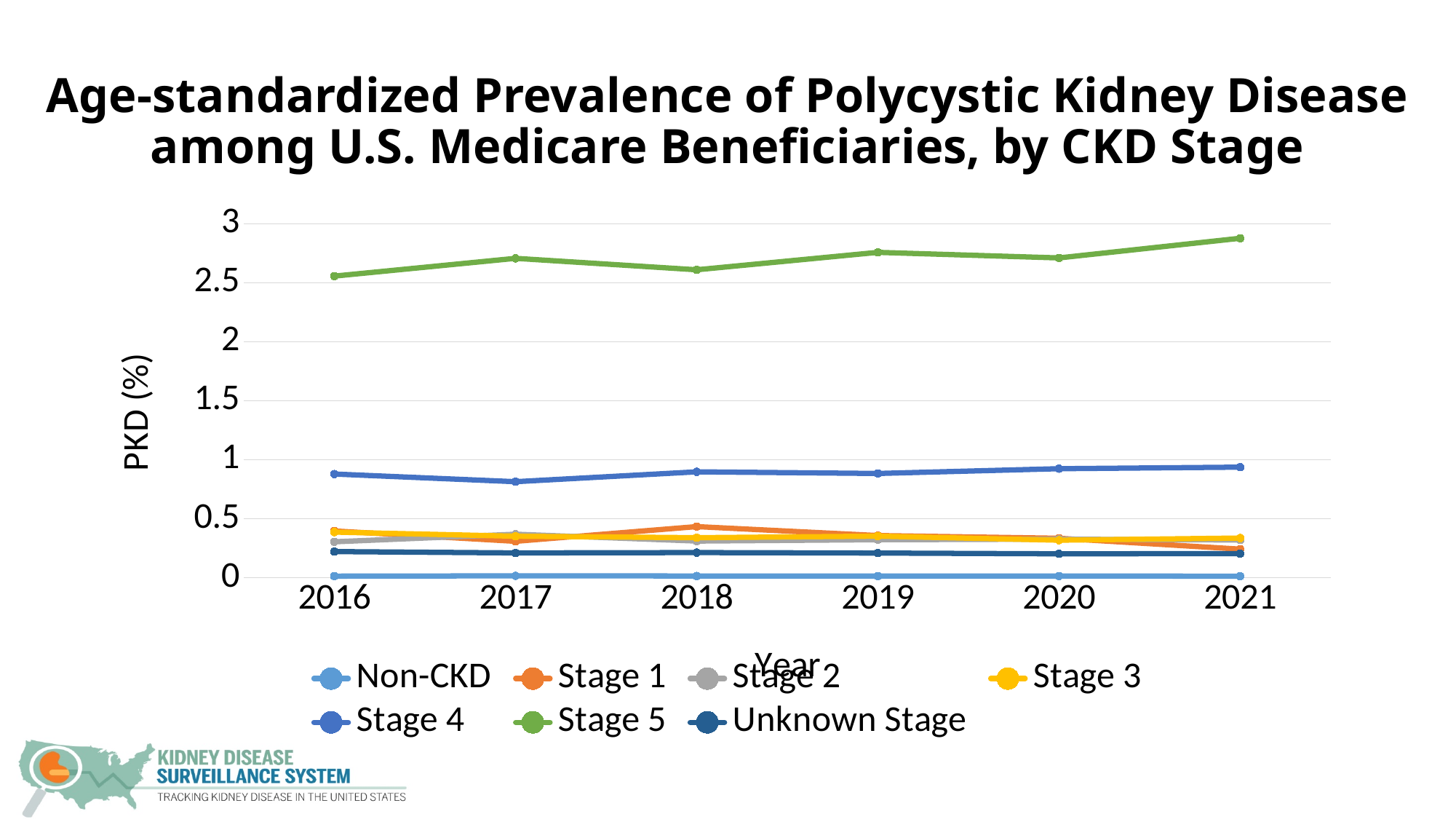
Which series has the lowest PKD prevalence across all years? Non-CKD What is the label on the y axis? PKD (%) How many years are plotted along the x axis? 6 In which year does the Stage 5 line reach its highest value? 2021 What kind of chart is shown on the slide? line chart In which year does the Stage 4 line reach its lowest value? 2017 Is the value for Stage 5 in 2019 greater or less than 2.5? greater In 2020, which is larger: the value for Stage 4 or the value for Stage 3? Stage 4 Is the value for Stage 1 in 2018 greater or less than 0.5? less Which CKD stage has the highest PKD prevalence across all years? Stage 5 How many series does the legend list? 7 Is the value for Stage 4 in 2017 greater or less than 1? less